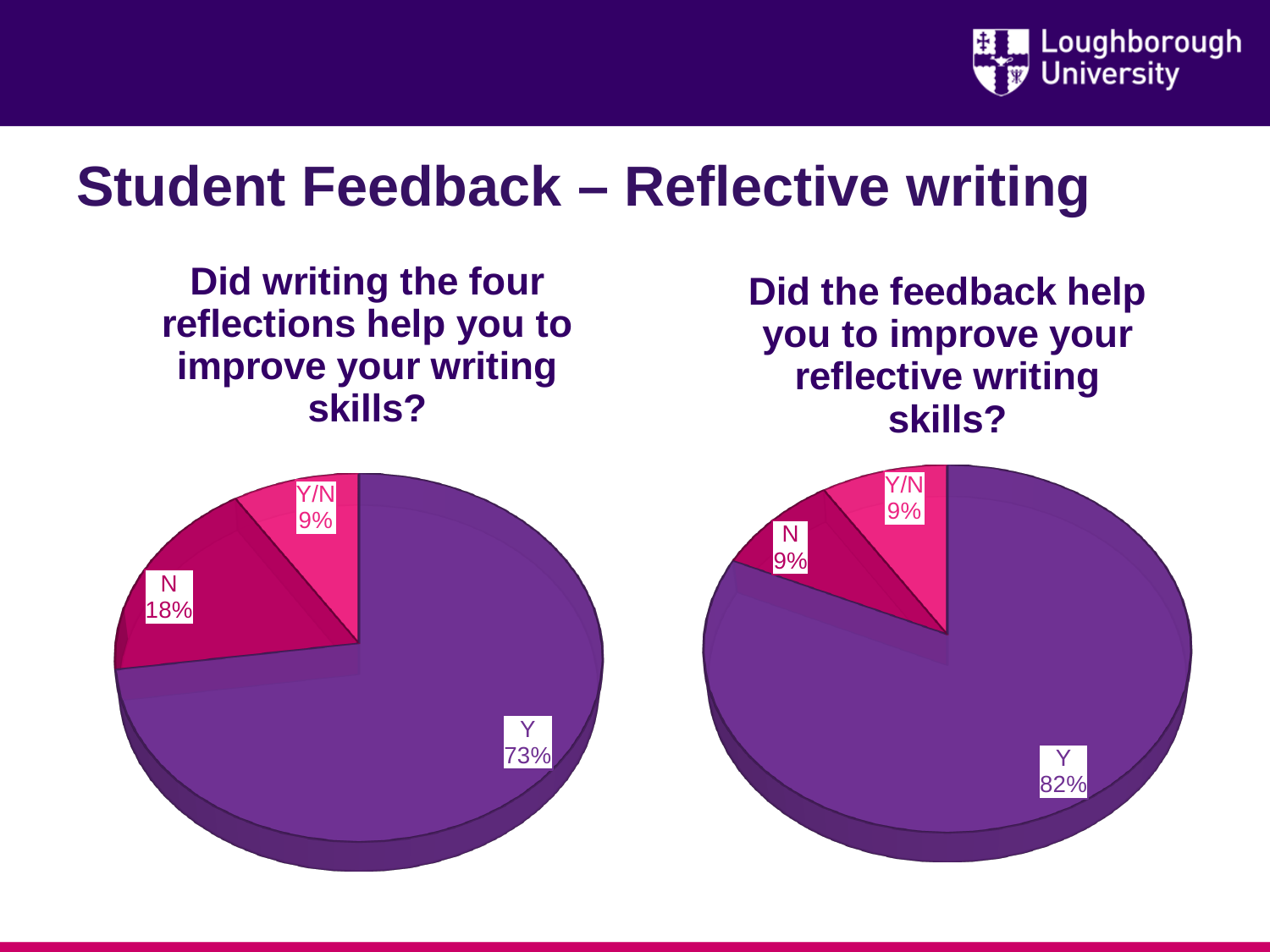
In the left pie chart, which response has the largest slice? Y In the right pie chart ("Did the feedback help you to improve your reflective writing skills?"), what share of responses is Y? 82% In the left pie chart, which response has the smallest slice? Y/N In the left pie chart, what is the difference in percentage points between the Y and N slices? 55 In the left pie chart ("Did writing the four reflections help you to improve your writing skills?"), what share of responses is N? 18% In the right pie chart ("Did the feedback help you to improve your reflective writing skills?"), what share of responses is N? 9% In the left pie chart, which is larger, the N slice or the Y/N slice? N What kind of chart is used on the left of the slide? Pie chart In the right pie chart, which response has the largest slice? Y How many slices does the right pie chart have? 3